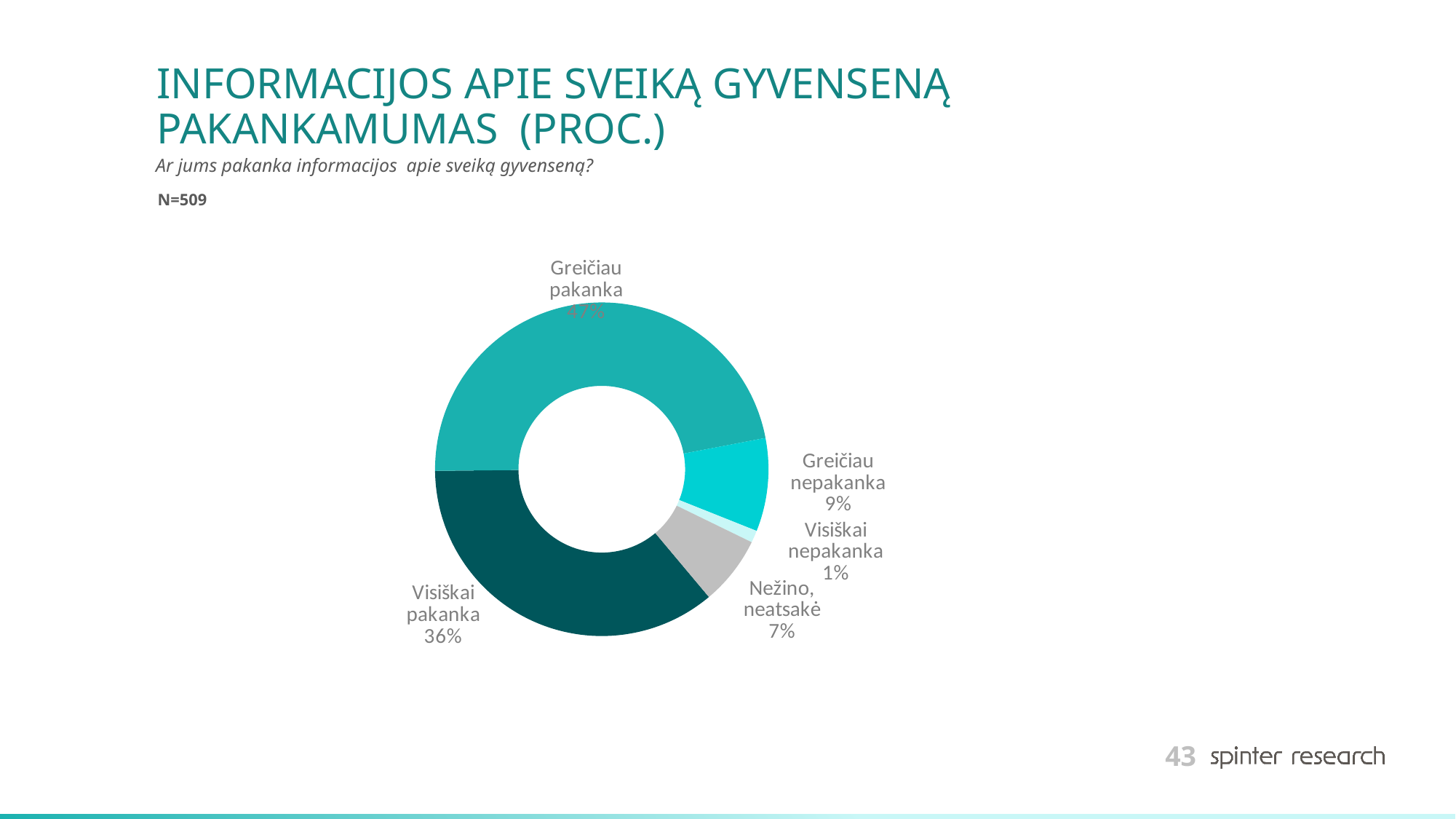
What type of chart is shown on the slide? Pie chart (donut) How many categories does the pie chart show? 5 What is the value for "Visiškai nepakanka"? 1% Which category has the largest share of the pie? Greičiau pakanka What is the value for "Greičiau nepakanka"? 9% What is the value for "Visiškai pakanka"? 36% What is the value for "Greičiau pakanka"? 47% What is the difference between "Visiškai pakanka" and "Greičiau nepakanka"? 27% What is the value for "Nežino, neatsakė"? 7% Which category has the smallest share of the pie? Visiškai nepakanka Which is larger, "Nežino, neatsakė" or "Greičiau nepakanka"? Greičiau nepakanka What sample size (N) is stated on the slide? N=509